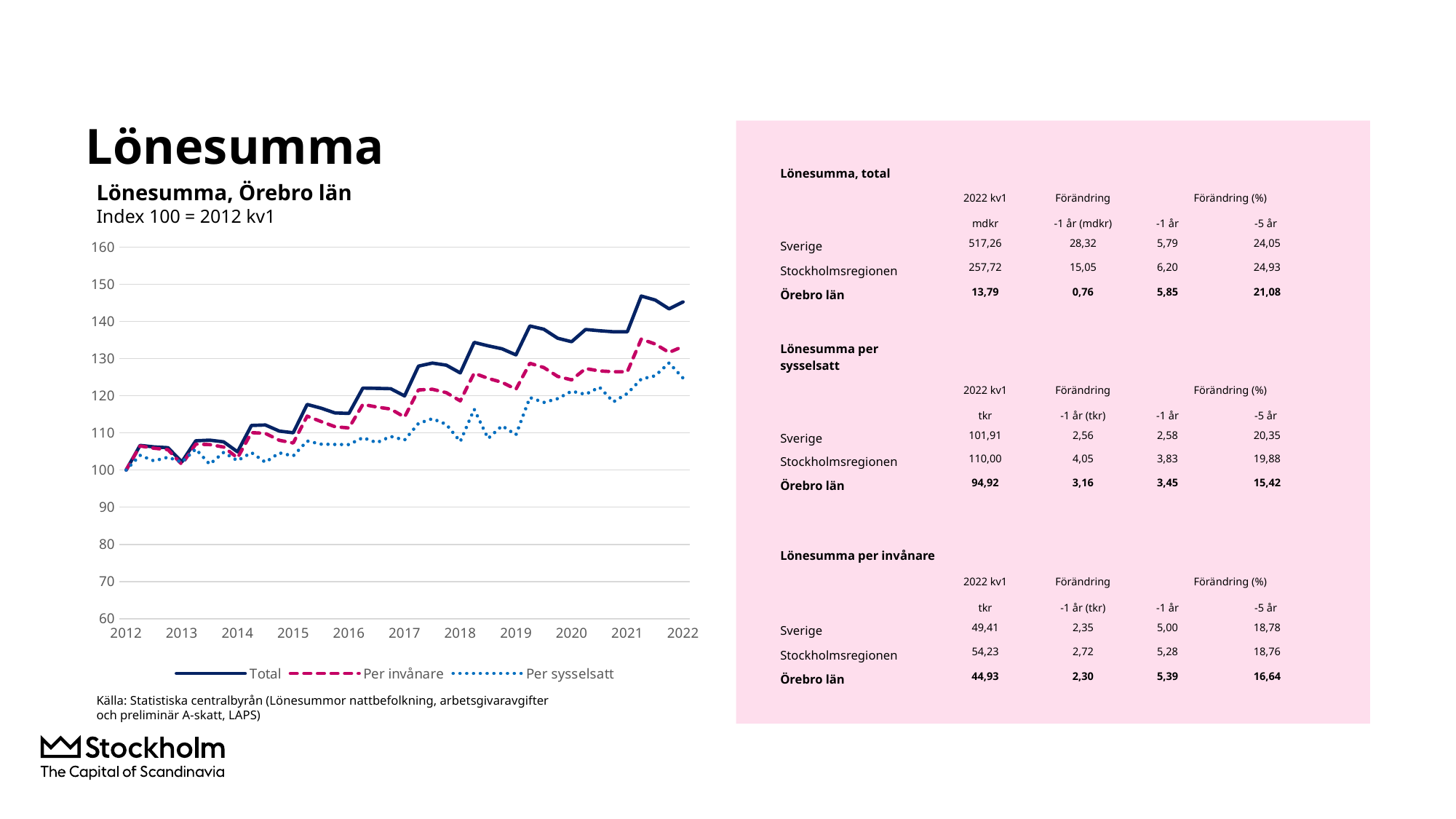
Which series has the highest value at 2022? Total Which series has the lowest value at 2022? Per sysselsatt What are the three series named in the chart legend? Total, Per invånare, Per sysselsatt What kind of chart is shown on the slide? line chart How many series does the legend of the chart list? 3 Does the Total series rise or fall from 2012 to 2022? rise Is the value of the Total series at 2022 greater or less than 140? greater At 2022, which is larger: the Total series or the Per sysselsatt series? Total Is the value of the Per invånare series at 2022 greater or less than 120? greater Is the value of the Per sysselsatt series at 2022 greater or less than 130? less What is the title of the chart? Lönesumma, Örebro län What index value do all three series start at in 2012 kv1? 100